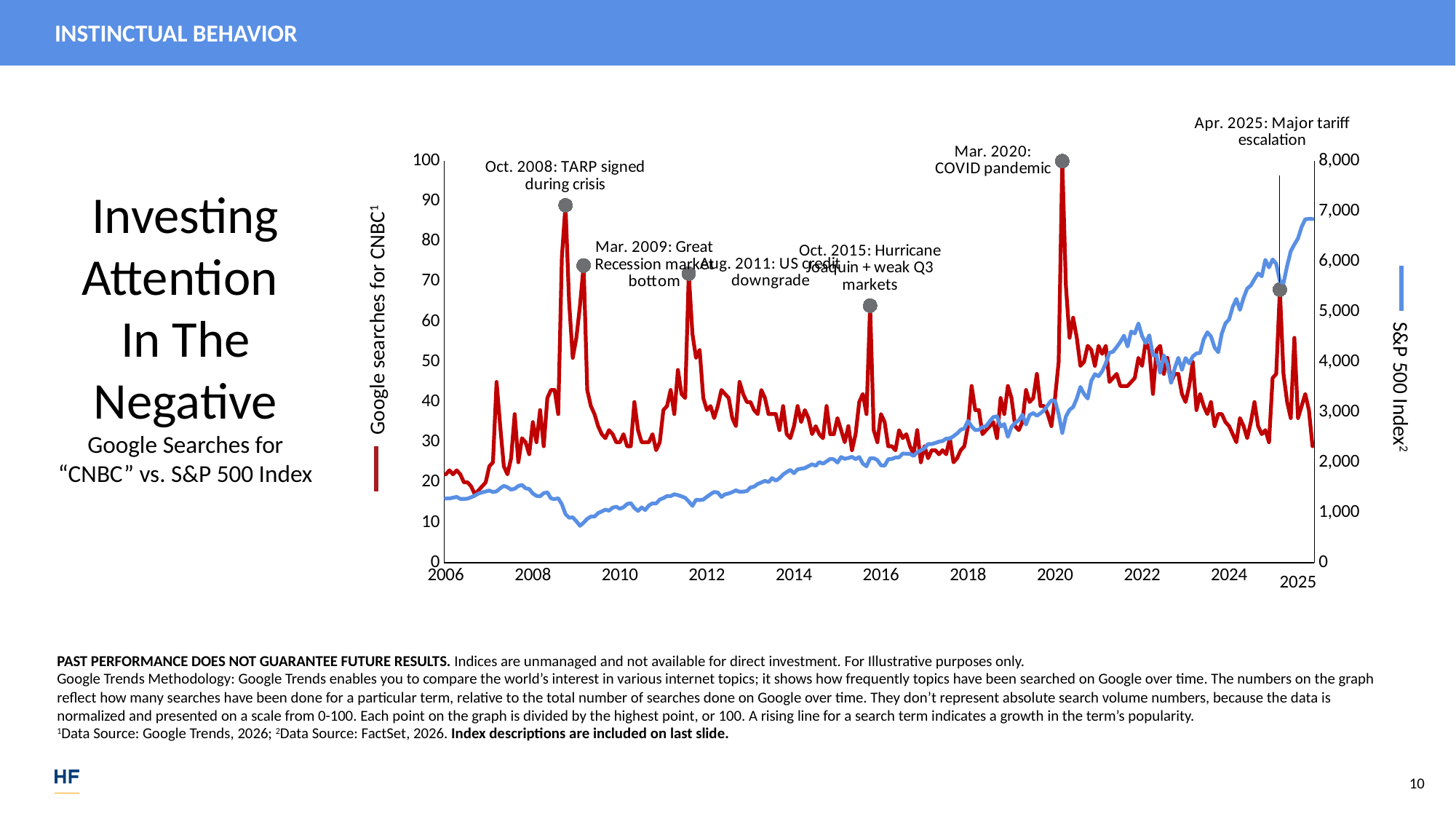
How many annotated events are marked on the chart? 6 What is the label of the right-hand vertical axis? S&P 500 Index Is the S&P 500 Index value at the end of the chart in 2025 greater or less than 6,000? greater Which peak in Google searches for CNBC is higher: the Oct. 2008 TARP peak or the Mar. 2009 Great Recession market bottom peak? Oct. 2008 TARP peak How many data series are plotted on the chart? 2 Which annotated event corresponds to the highest peak in Google searches for CNBC? Mar. 2020: COVID pandemic Is the Google searches for CNBC value at the Oct. 2015 Hurricane Joaquin peak greater or less than 70? less What kind of chart is shown on the slide? Line chart Does the S&P 500 Index line generally rise or fall from 2006 to 2025? Rise Is the Google searches for CNBC value at the Mar. 2020 COVID pandemic peak greater or less than 90? greater